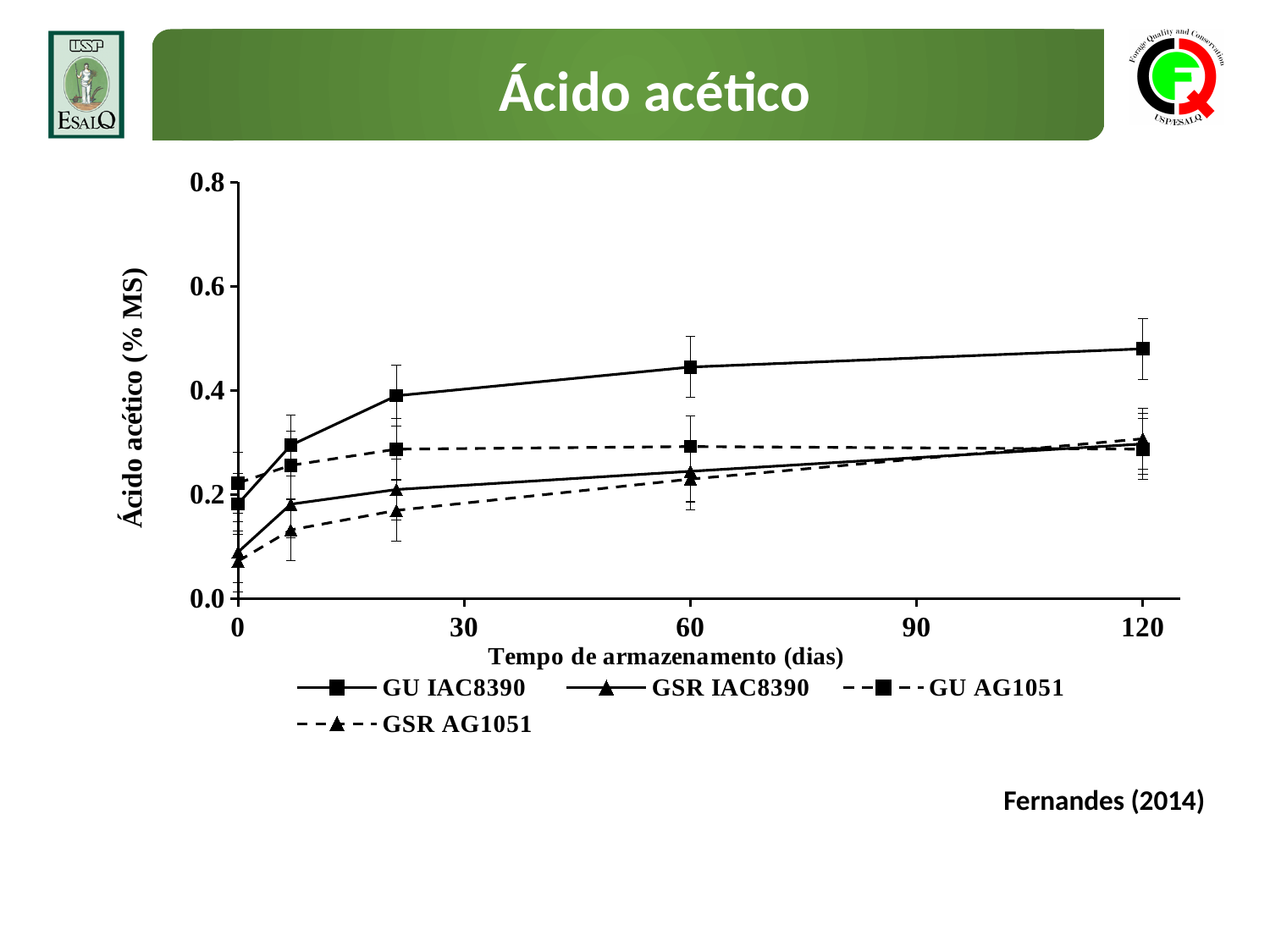
Which series has the highest value at 0 days? GU AG1051 At 0 days, which is larger: GU IAC8390 or GSR IAC8390? GU IAC8390 Is the value for GSR AG1051 at 0 days greater or less than 0.2? less At 60 days, which is larger: GU IAC8390 or GU AG1051? GU IAC8390 What kind of chart is shown on the slide? line chart Is the value for GU IAC8390 at 120 days greater or less than 0.4? greater Is the value for GU IAC8390 at 60 days greater or less than 0.4? greater How many time points are plotted for each series? 5 Which series has the highest acetic acid value at 120 days? GU IAC8390 How many series does the legend list? 4 What is the title of the x axis? Tempo de armazenamento (dias) Does the GU IAC8390 series rise or fall as storage time increases? rise